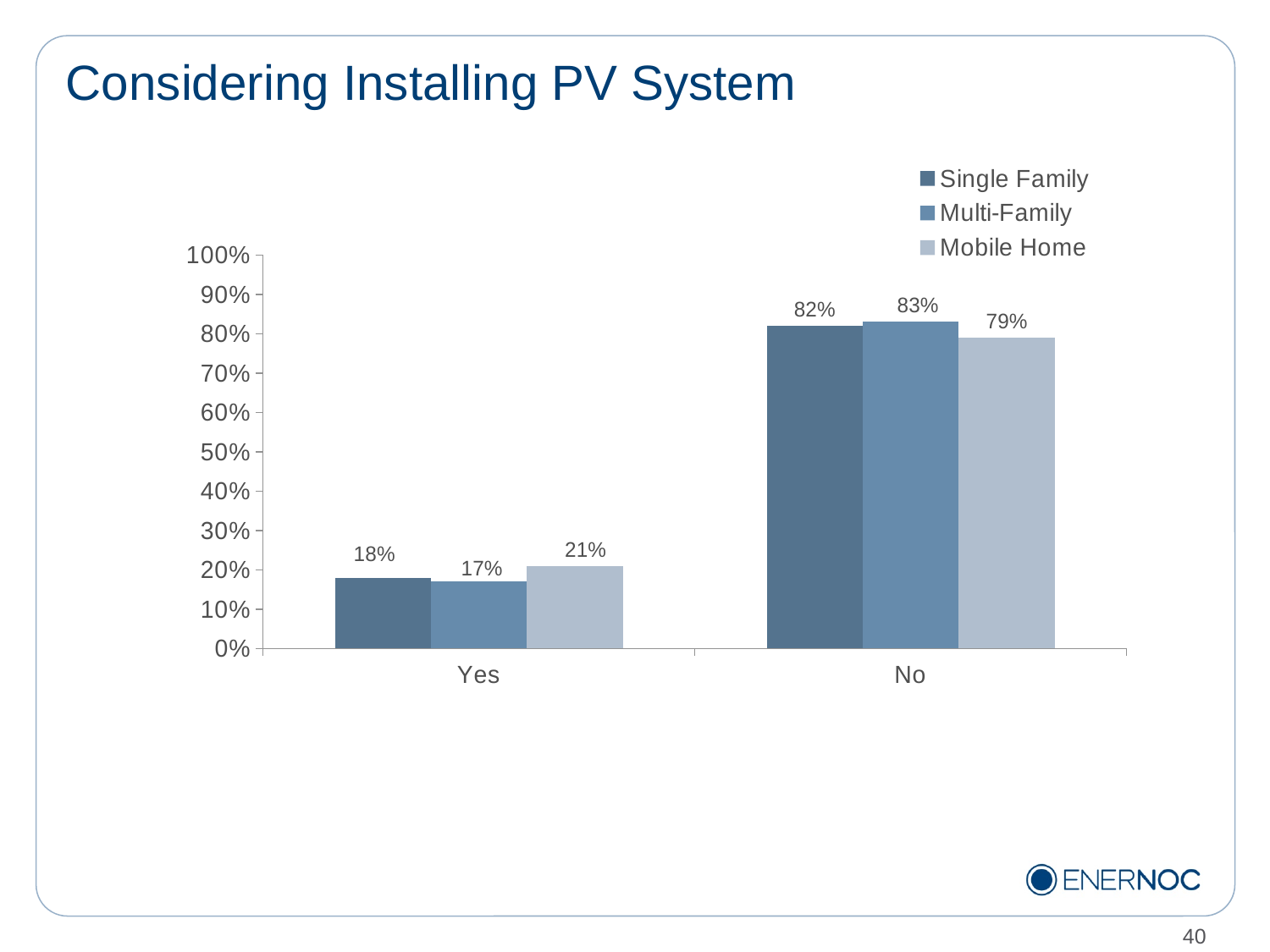
What percentage of Multi-Family respondents answered Yes? 17% Which series has the lowest value in the Yes category? Multi-Family How many categories are shown on the x axis? 2 What percentage of Single Family respondents answered Yes? 18% What percentage of Mobile Home respondents answered No? 79% Is the Multi-Family value for No greater or less than 80%? greater What is the title of the slide? Considering Installing PV System What kind of chart is shown on the slide? Bar chart Which series has the highest value in the No category? Multi-Family How many series does the legend list? 3 Which is larger: the Single Family No value or the Mobile Home No value? Single Family What is the difference between the Mobile Home Yes value and the Single Family Yes value? 3%